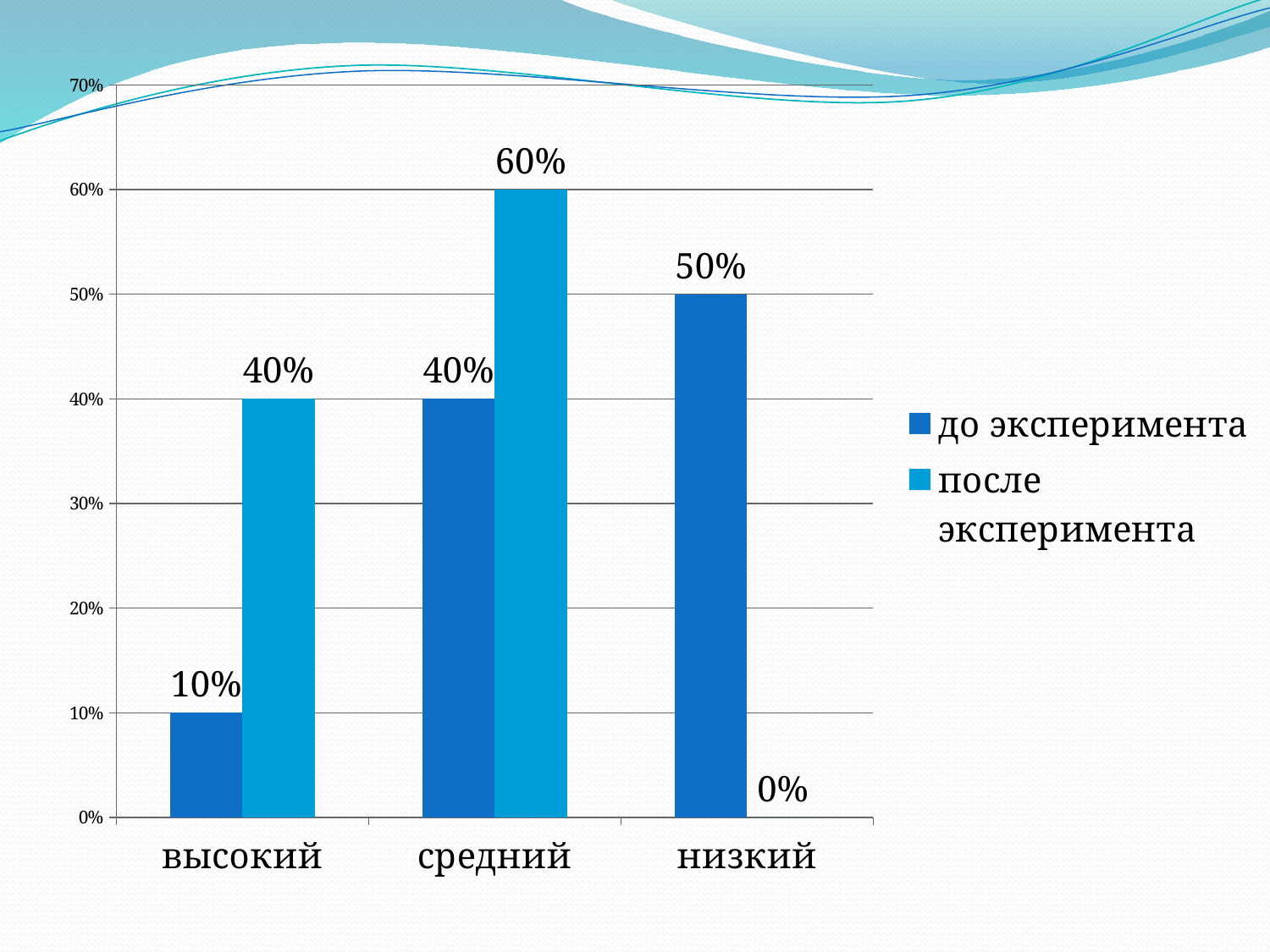
Which category has the highest value in the "после эксперимента" series? средний How many series does the legend list? 2 What is the value for "средний" in the "после эксперимента" series? 60% What is the value for "низкий" in the "до эксперимента" series? 50% Which category has the lowest value in the "до эксперимента" series? высокий What kind of chart is shown on the slide? bar chart What is the value for "низкий" in the "после эксперимента" series? 0% Which is larger for "низкий": the "до эксперимента" value or the "после эксперимента" value? до эксперимента What is the value for "высокий" in the "до эксперимента" series? 10% How many categories are shown on the x axis? 3 What is the difference between the "после эксперимента" and "до эксперимента" values for "высокий"? 30% What is the value for "высокий" in the "после эксперимента" series? 40%